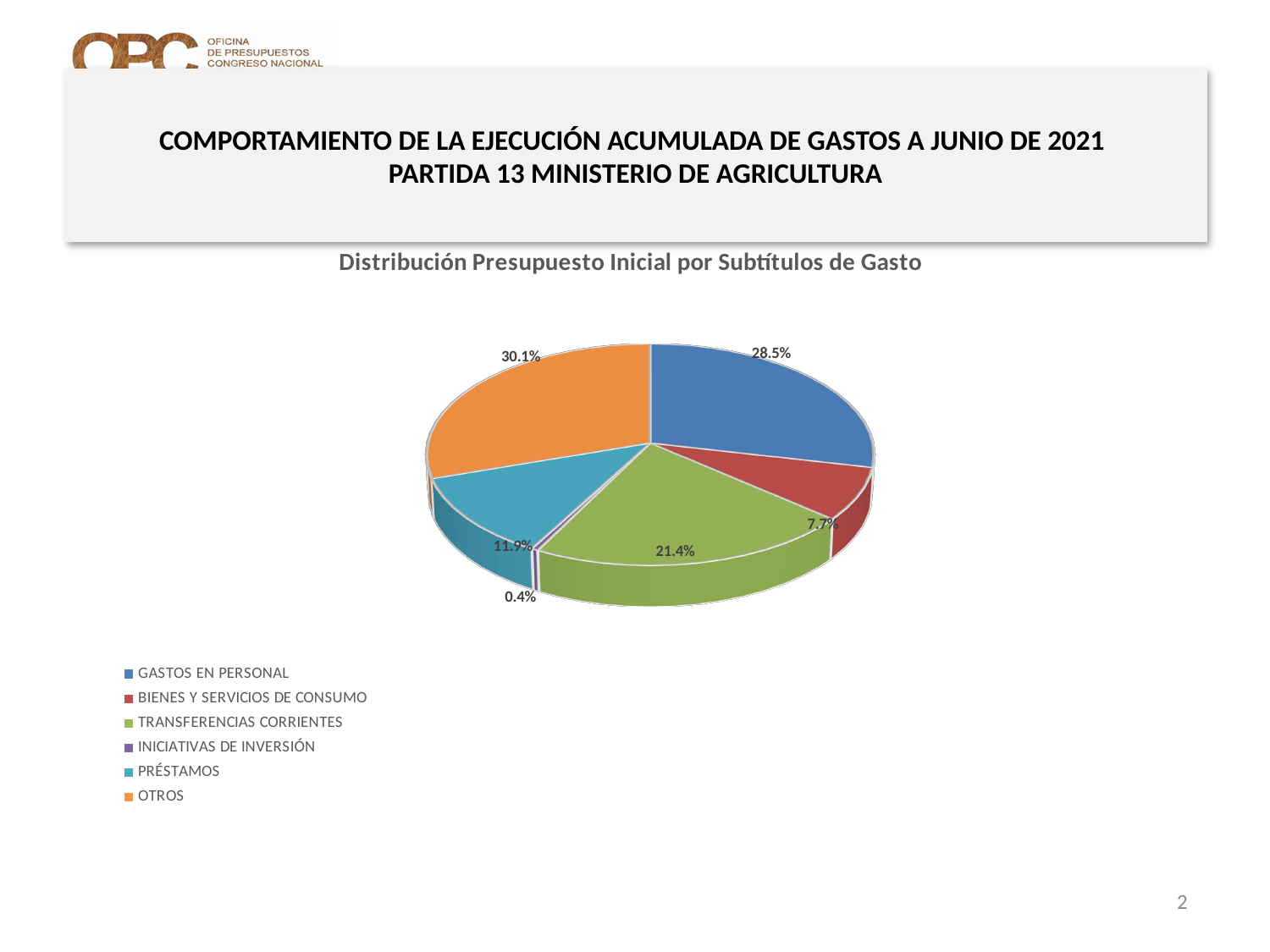
What share of the pie does PRÉSTAMOS represent? 11.9% Which category has the largest share of the pie? OTROS What share of the pie does TRANSFERENCIAS CORRIENTES represent? 21.4% Which category has the smallest share of the pie? INICIATIVAS DE INVERSIÓN What share of the pie does GASTOS EN PERSONAL represent? 28.5% What share of the pie does INICIATIVAS DE INVERSIÓN represent? 0.4% How many categories does the legend list? 6 What share of the pie does BIENES Y SERVICIOS DE CONSUMO represent? 7.7% Which is larger, the share for TRANSFERENCIAS CORRIENTES or the share for PRÉSTAMOS? TRANSFERENCIAS CORRIENTES What is the chart's title? Distribución Presupuesto Inicial por Subtítulos de Gasto What is the difference in percentage points between OTROS and GASTOS EN PERSONAL? 1.6 What kind of chart is shown on the slide? Pie chart